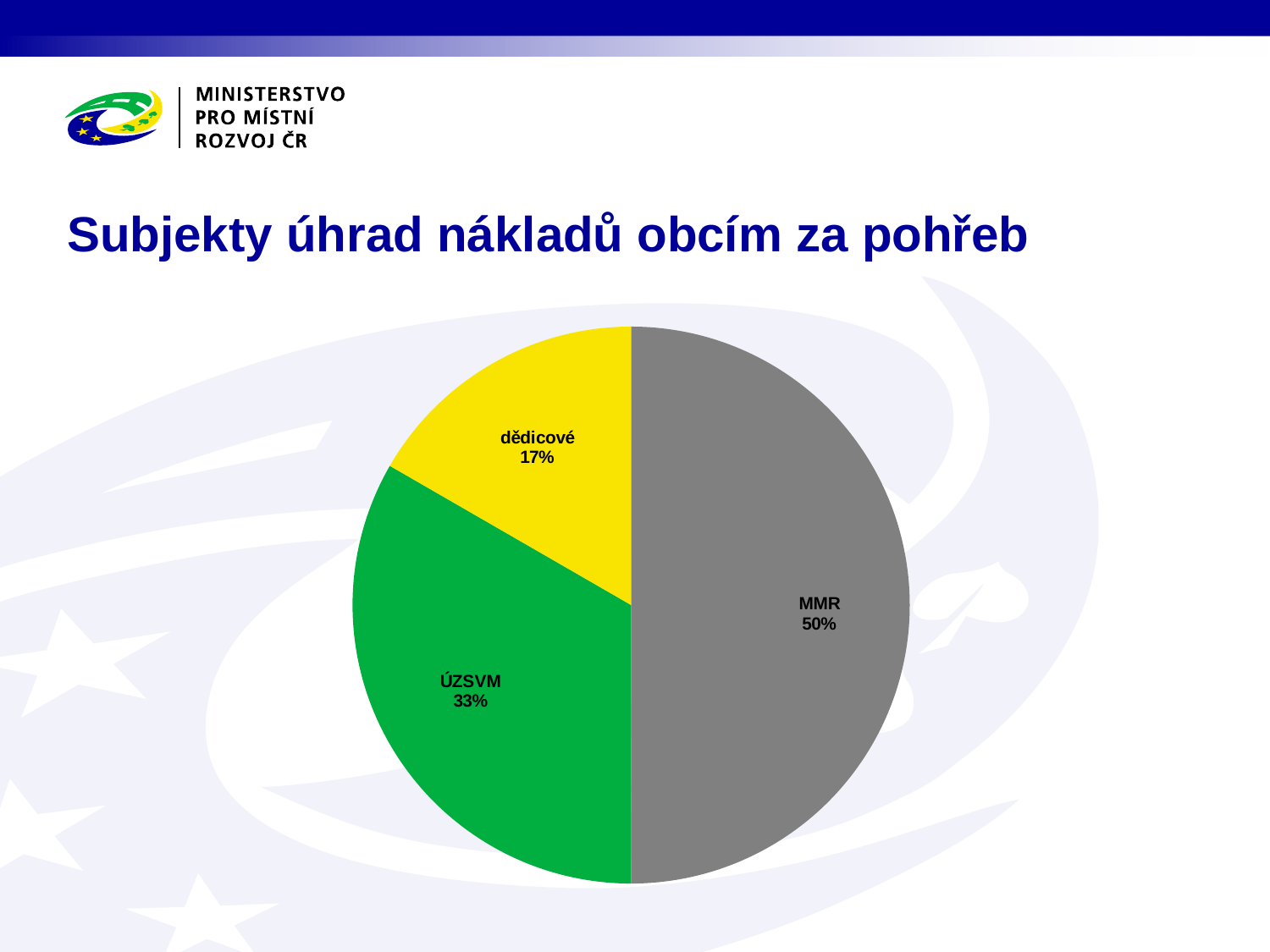
What is the difference in percentage points between the MMR slice and the ÚZSVM slice? 17 What is the title of the slide containing the pie chart? Subjekty úhrad nákladů obcím za pohřeb What is the difference in percentage points between the ÚZSVM slice and the dědicové slice? 16 What colour is the MMR slice of the pie? grey Which is larger, the ÚZSVM slice or the dědicové slice? ÚZSVM What type of chart is shown on the slide? pie chart Which category has the largest slice of the pie? MMR Which category has the smallest slice of the pie? dědicové How many slices does the pie chart have? 3 What share of the pie does MMR account for? 50% What share of the pie does dědicové account for? 17% What share of the pie does ÚZSVM account for? 33%